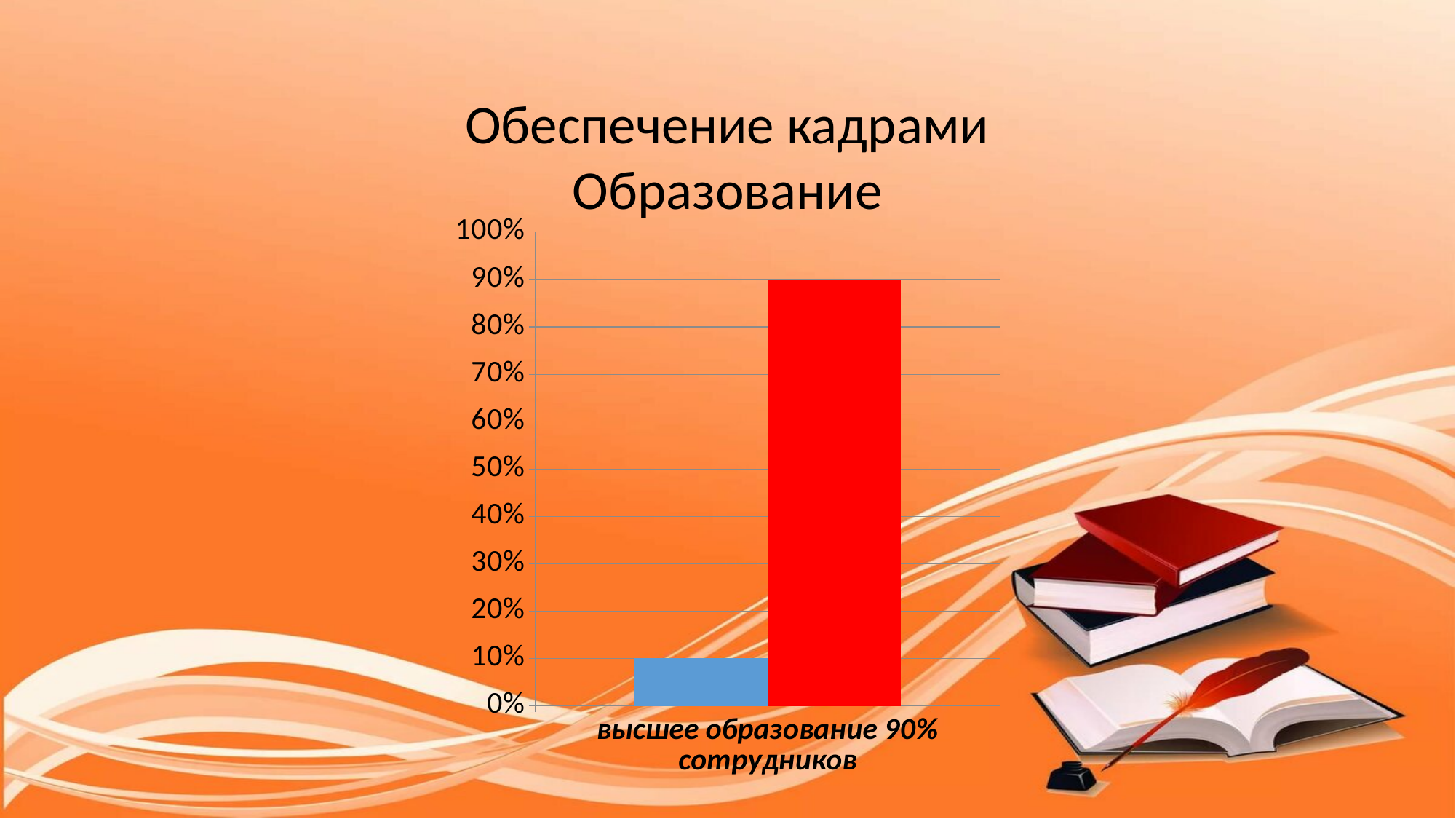
What value does the red bar reach? 90% What is the category label shown under the bars? высшее образование 90% сотрудников What is the highest value shown on the vertical axis? 100% Is the value of the red bar greater or less than 50%? greater What is the title of the chart? Обеспечение кадрами Образование What is the difference between the red bar and the blue bar? 80% How many bars are plotted in the chart? 2 What kind of chart is shown on the slide? bar chart Is the value of the blue bar greater or less than 20%? less Which bar is taller, the red bar or the blue bar? the red bar What value does the blue bar reach? 10%